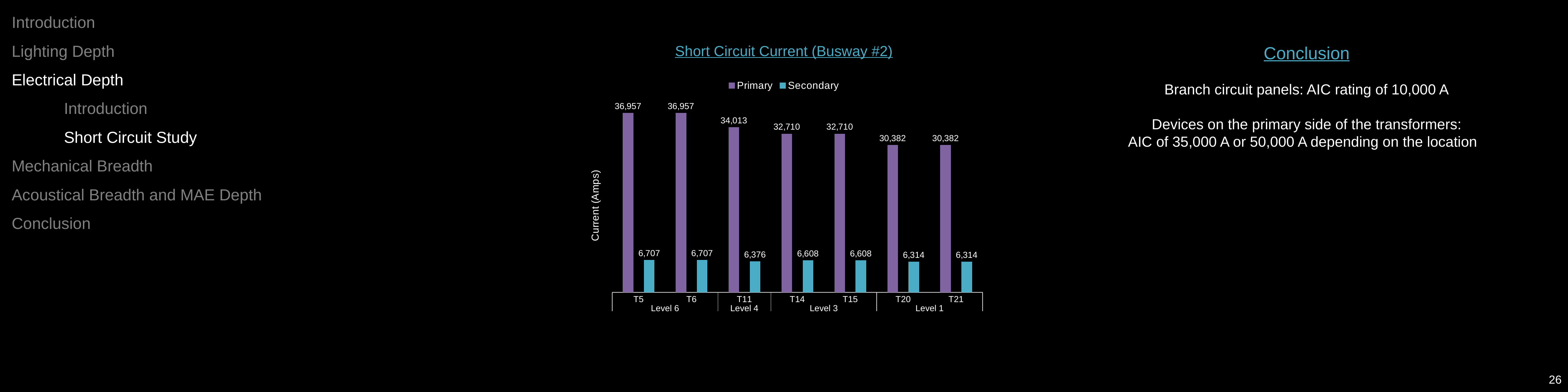
Which is larger, the Secondary value for T11 or the Secondary value for T14? T14 What kind of chart is shown? Bar chart How many transformers are shown on the x axis? 7 How many series does the legend list? 2 Which transformer has the lowest Secondary short circuit current? T20 and T21 (6,314) What is the difference between the Primary values for T5 and T21? 6,575 What is the Secondary value for T5? 6,707 What is the difference between the Primary and Secondary values for T11? 27,637 What is the Primary short circuit current for T11? 34,013 What is the Primary value for T20? 30,382 What is the Secondary short circuit current for T14? 6,608 Do the Primary values rise or fall from T5 to T21? Fall